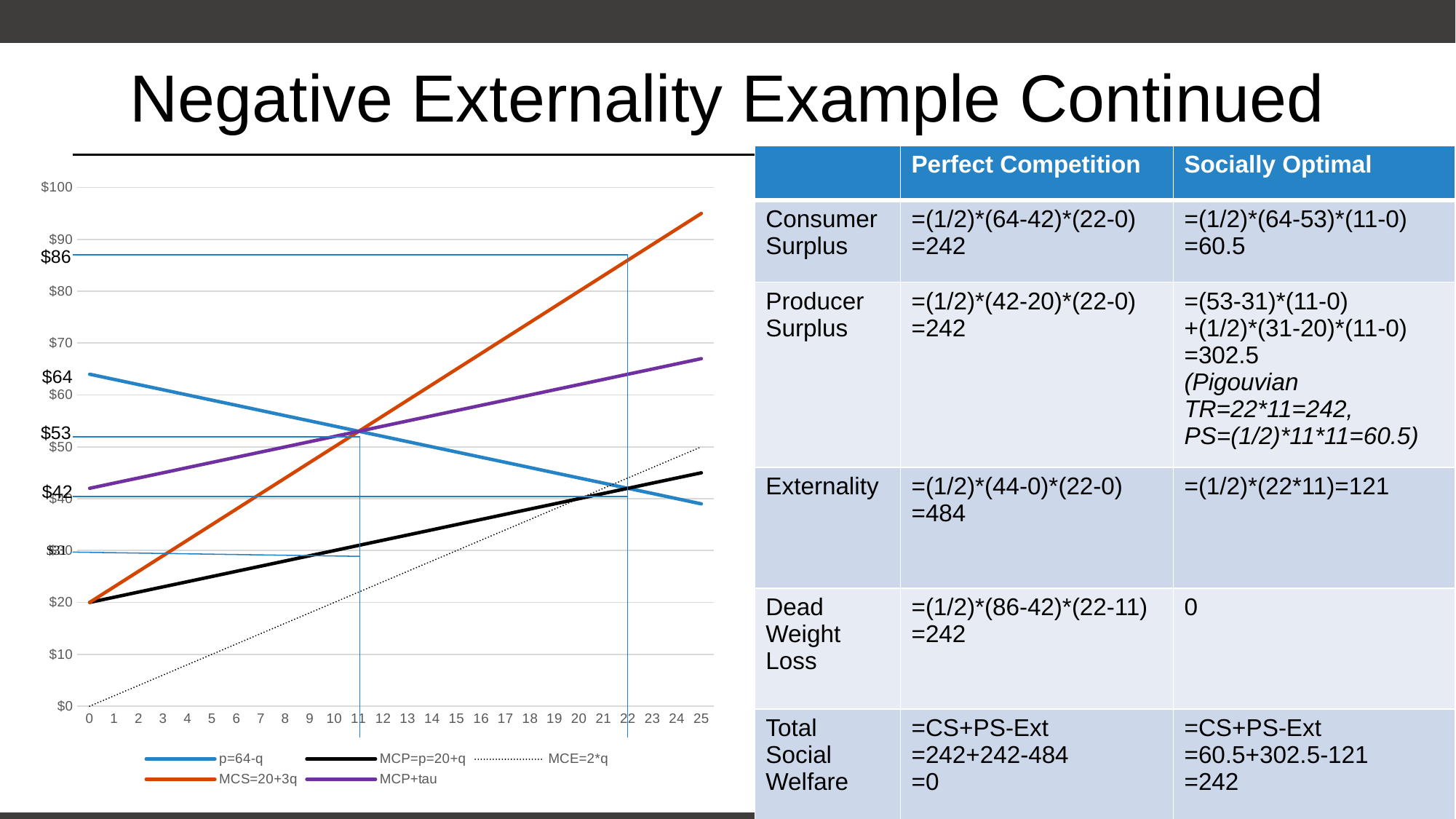
What is the value of the MCE=2*q line at quantity 0? $0 What is the value of the MCS=20+3q line at quantity 0? $20 What is the highest value shown on the chart's vertical axis? $100 Does the MCS=20+3q line rise or fall as quantity increases? rise What kind of chart is shown on the left of the slide? line chart What is the value of the p=64-q line at quantity 0? $64 Which series is drawn as a dotted line in the chart? MCE=2*q How many series does the chart legend list? 5 Does the p=64-q line rise or fall as quantity increases? fall Is the value of the MCP+tau line at quantity 25 greater or less than $60? greater Which series has the highest value at quantity 25? MCS=20+3q Which series has the lowest value at quantity 0? MCE=2*q